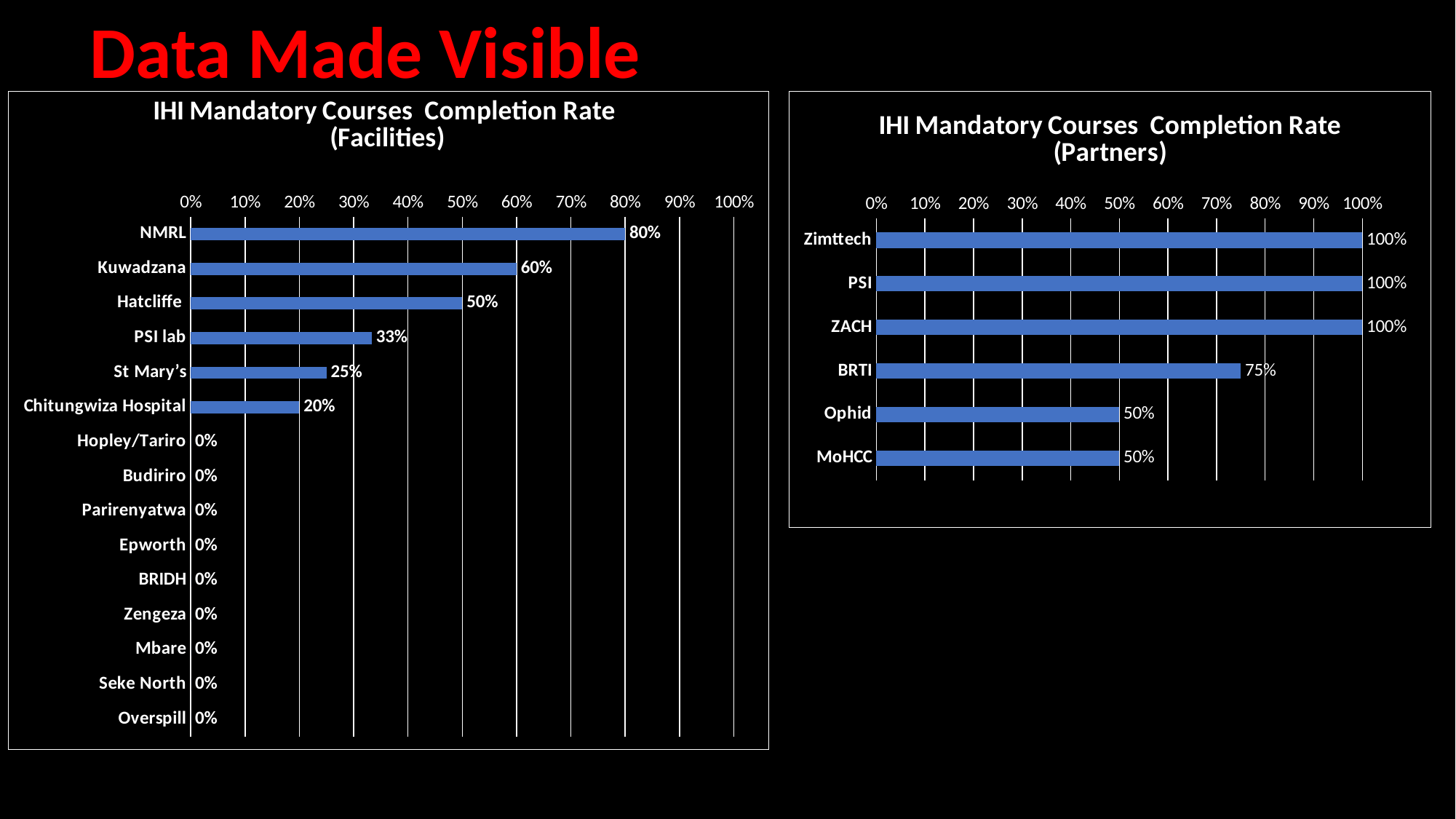
In the Facilities chart, what is the difference between the completion rates of Kuwadzana and Hatcliffe? 10% In the Facilities chart, how many facilities have a completion rate of 0%? 9 In the Facilities chart, what is the completion rate for PSI lab? 33% In the Partners chart, which partner has the lowest completion rate? Ophid and MoHCC In the Partners chart, which is larger, the completion rate for ZACH or for BRTI? ZACH In the Facilities chart, what is the completion rate for NMRL? 80% What is the title of the chart on the left of the slide? IHI Mandatory Courses Completion Rate (Facilities) In the Facilities chart, which facility has the highest completion rate? NMRL What kind of chart is the Partners chart? Bar chart In the Facilities chart, how many facilities are listed? 15 In the Partners chart, what is the completion rate for BRTI? 75% In the Partners chart, how many partners are listed? 6